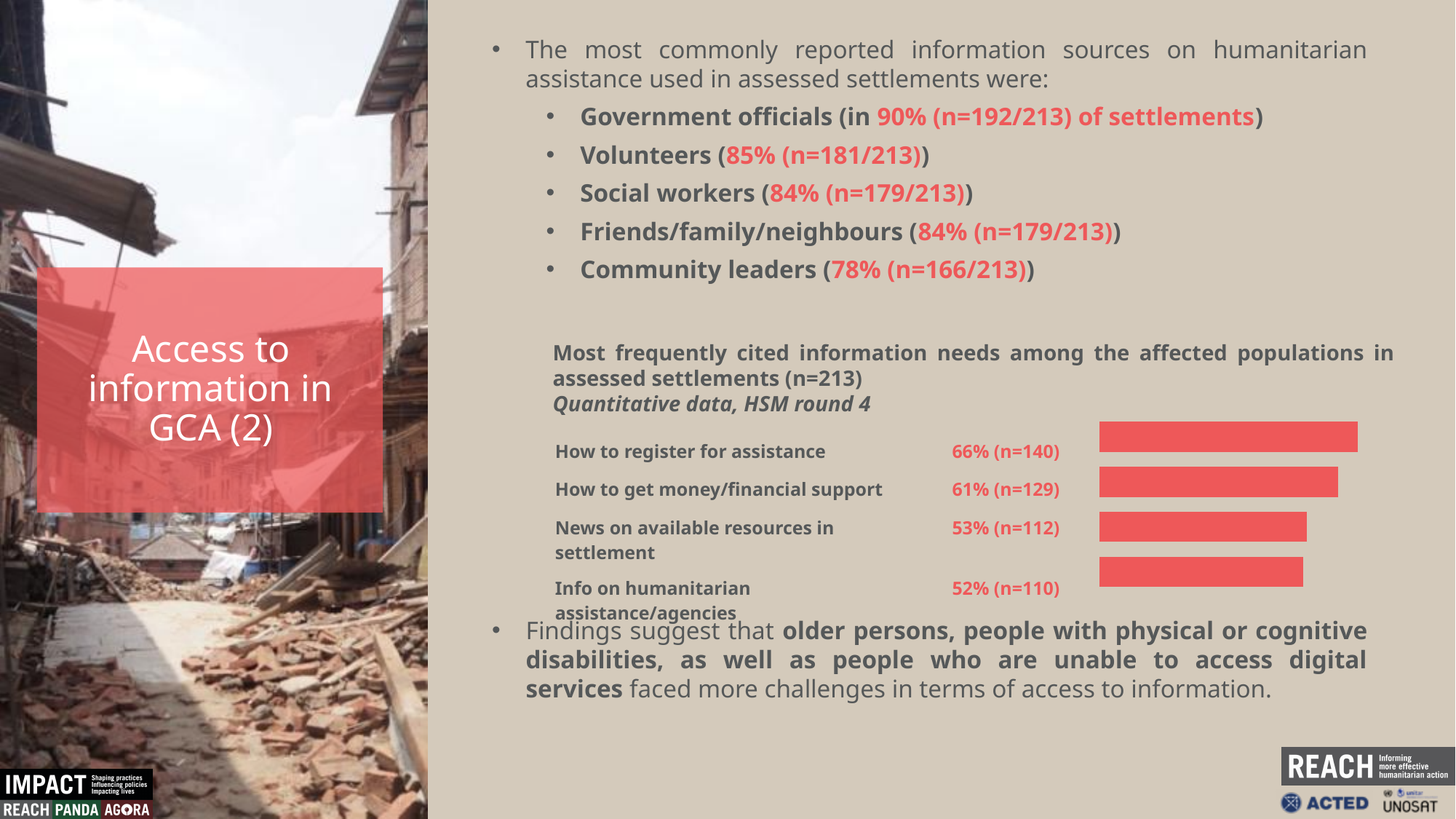
What percentage is shown for 'How to register for assistance' in the information needs chart? 66% What is the n value shown for 'How to get money/financial support' in the information needs chart? n=129 What percentage is shown for 'News on available resources in settlement' in the information needs chart? 53% What is the sample size (n) stated in the title of the information needs chart? n=213 Which information need has the lowest percentage in the chart? Info on humanitarian assistance/agencies What is the data label for 'Info on humanitarian assistance/agencies' in the information needs chart? 52% (n=110) Which information need has the highest percentage in the chart? How to register for assistance What is the difference in n between 'How to register for assistance' and 'Info on humanitarian assistance/agencies'? 30 What is the difference in percentage points between 'How to register for assistance' and 'How to get money/financial support'? 5 percentage points What kind of chart is used to show the information needs? Bar chart Which has a higher percentage: 'How to get money/financial support' or 'News on available resources in settlement'? How to get money/financial support How many information needs are plotted in the chart? 4